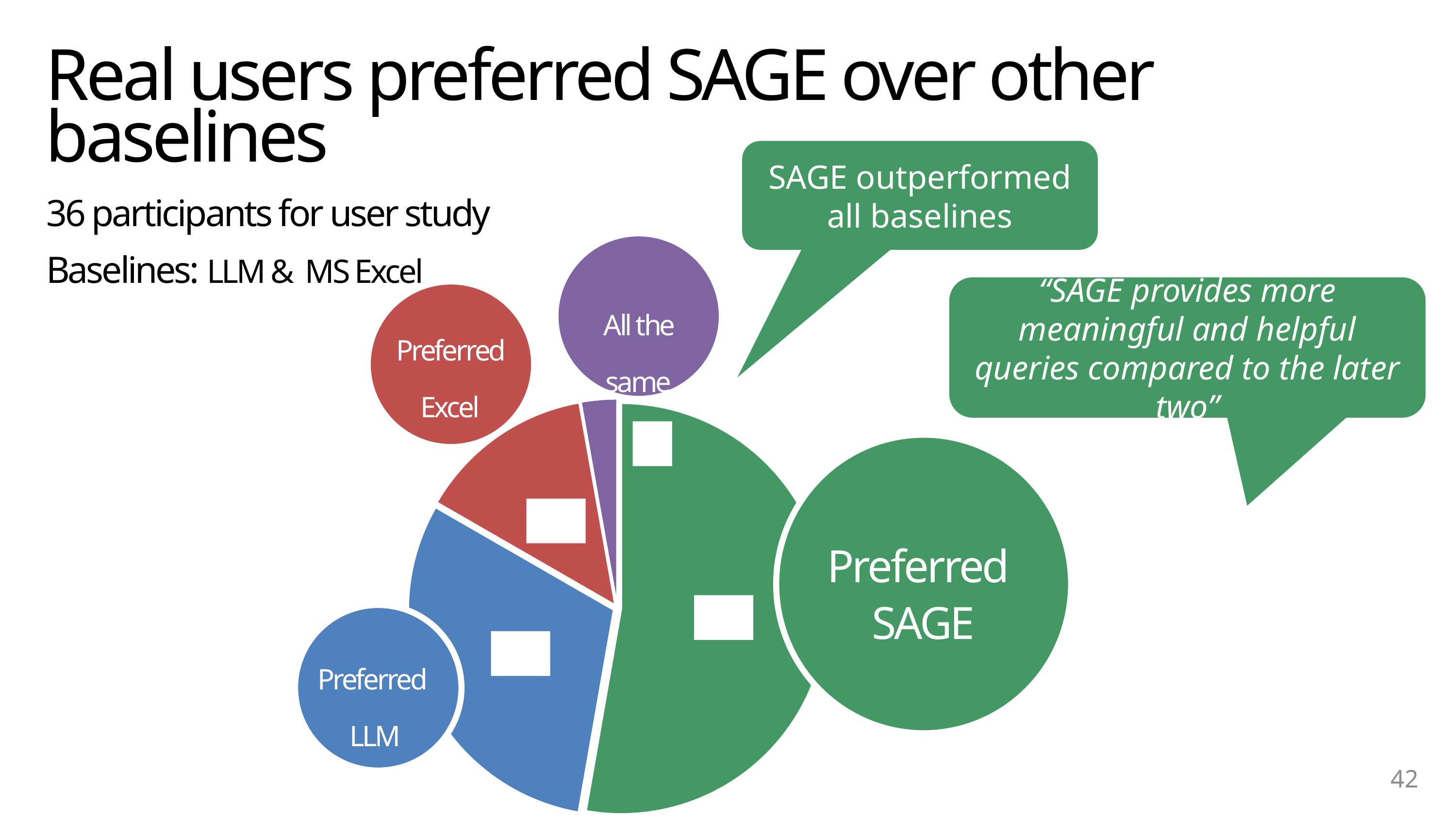
Which slice is larger, Preferred LLM or Preferred Excel? Preferred LLM Which category has the largest slice of the pie chart? Preferred SAGE Which slice is larger, Preferred SAGE or Preferred LLM? Preferred SAGE What colour is the Preferred LLM slice of the pie chart? blue Which category is shown in purple on the pie chart? All the same What kind of chart is shown on the slide? pie chart What colour is the Preferred SAGE slice of the pie chart? green Which category has the smallest slice of the pie chart? All the same How many slices does the pie chart have? 4 Which slice is larger, Preferred Excel or All the same? Preferred Excel